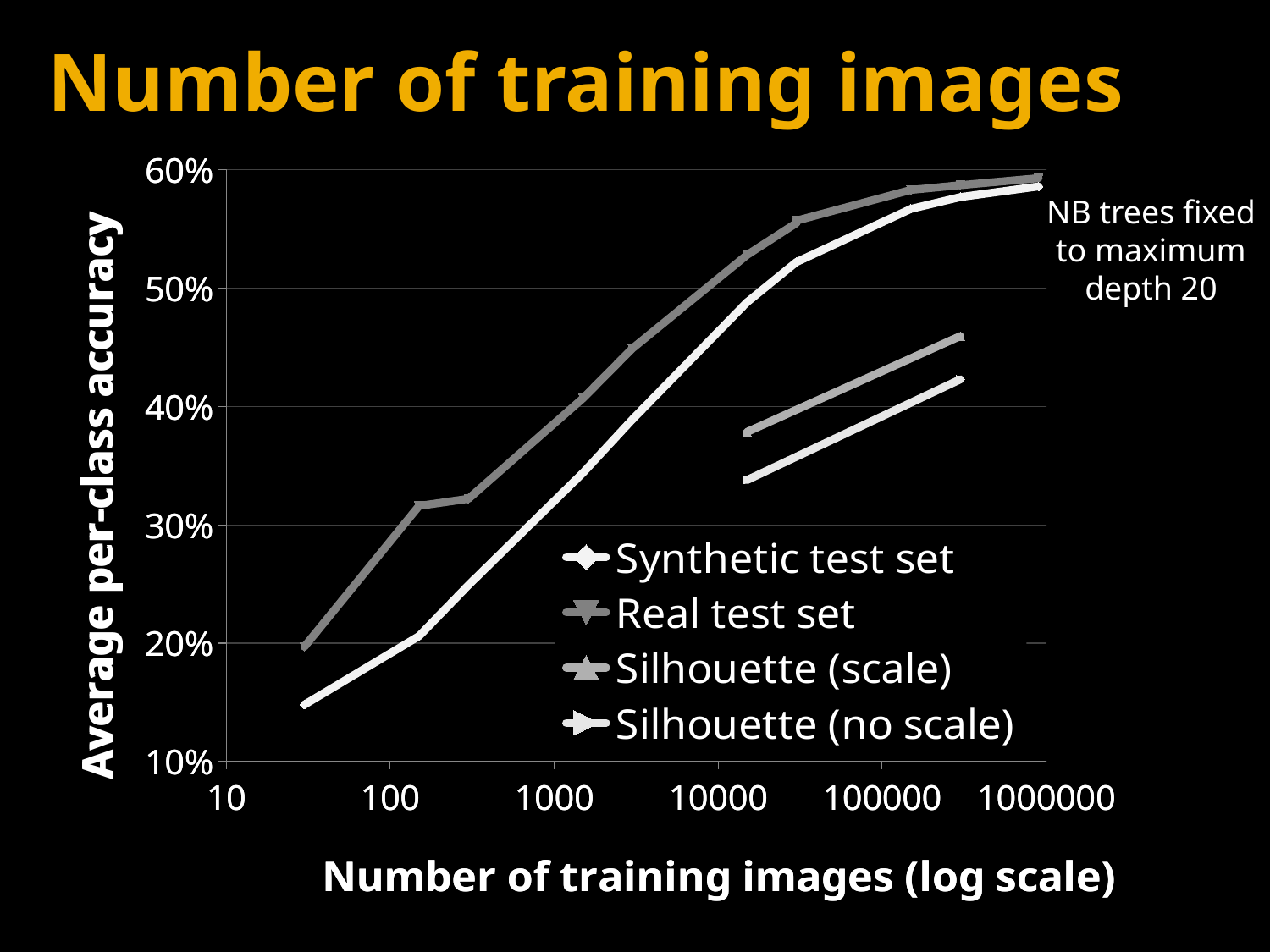
Does the accuracy of the Synthetic test set rise or fall as the number of training images increases? Rises Which series has the higher accuracy: Silhouette (scale) or Silhouette (no scale)? Silhouette (scale) How many series does the legend list? 4 What is the title of the chart? Number of training images Does the accuracy of the Real test set rise or fall as the number of training images increases? Rises Is the value for the Real test set at 1000000 training images greater or less than 50%? greater At 10000 training images, which has the higher accuracy: the Real test set or the Synthetic test set? Real test set What is the label of the vertical axis? Average per-class accuracy What kind of chart is shown on the slide? Line chart Is the value for the Synthetic test set at its leftmost point (around 30 training images) greater or less than 20%? less Is the value for Silhouette (no scale) at its leftmost point greater or less than 40%? less